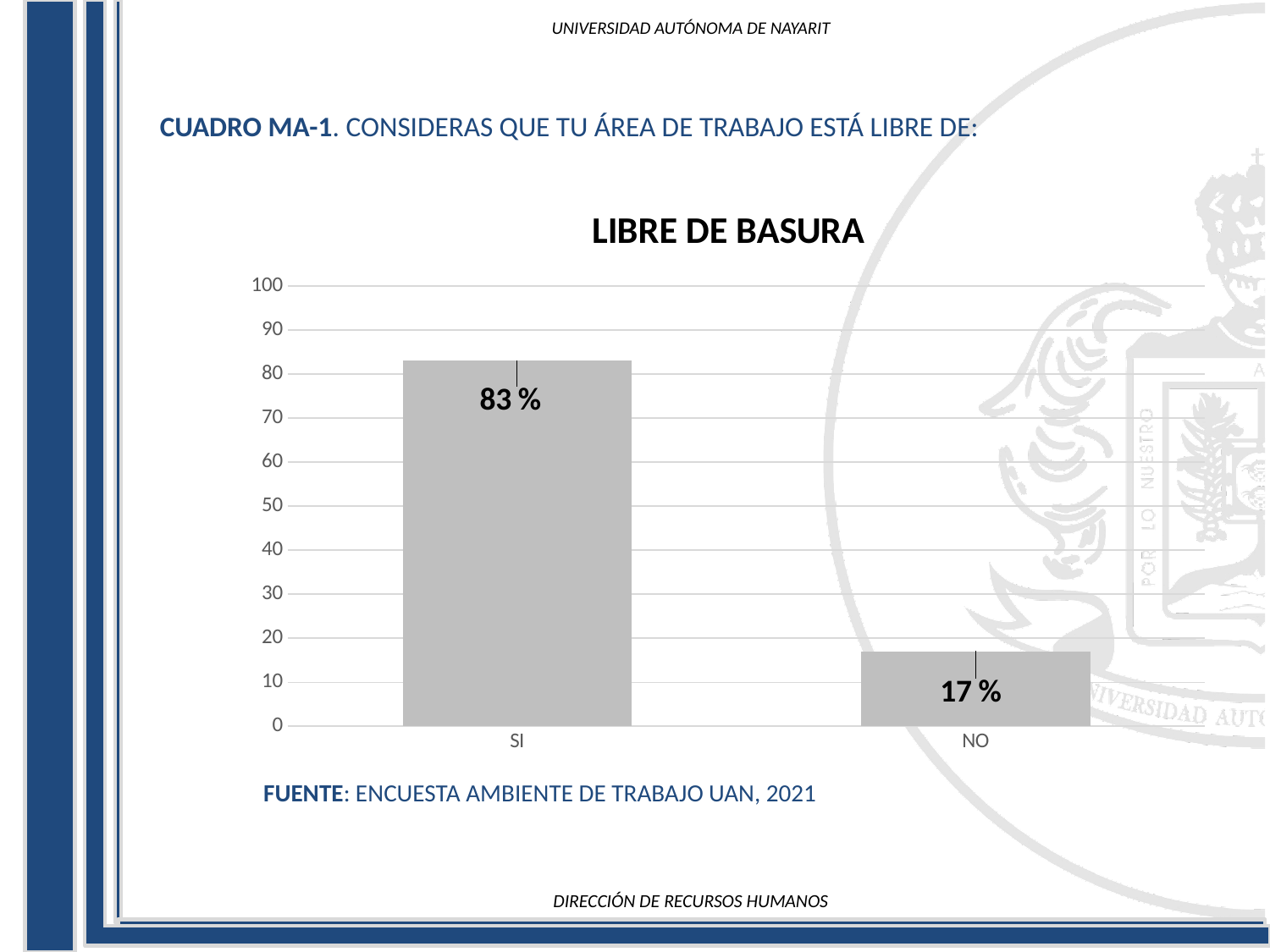
Which is larger in the LIBRE DE BASURA chart, the value for SI or the value for NO? SI Which category has the highest value in the LIBRE DE BASURA chart? SI What is the value for SI in the LIBRE DE BASURA chart? 83 % What kind of chart is the LIBRE DE BASURA chart? bar chart What is the source cited below the chart? ENCUESTA AMBIENTE DE TRABAJO UAN, 2021 Is the value for SI greater or less than 80 in the LIBRE DE BASURA chart? greater What is the title of the chart on the slide? LIBRE DE BASURA How many categories are shown in the LIBRE DE BASURA chart? 2 Which category has the lowest value in the LIBRE DE BASURA chart? NO What is the difference between the values for SI and NO in the LIBRE DE BASURA chart? 66 % Is the value for NO greater or less than 20 in the LIBRE DE BASURA chart? less What is the value for NO in the LIBRE DE BASURA chart? 17 %